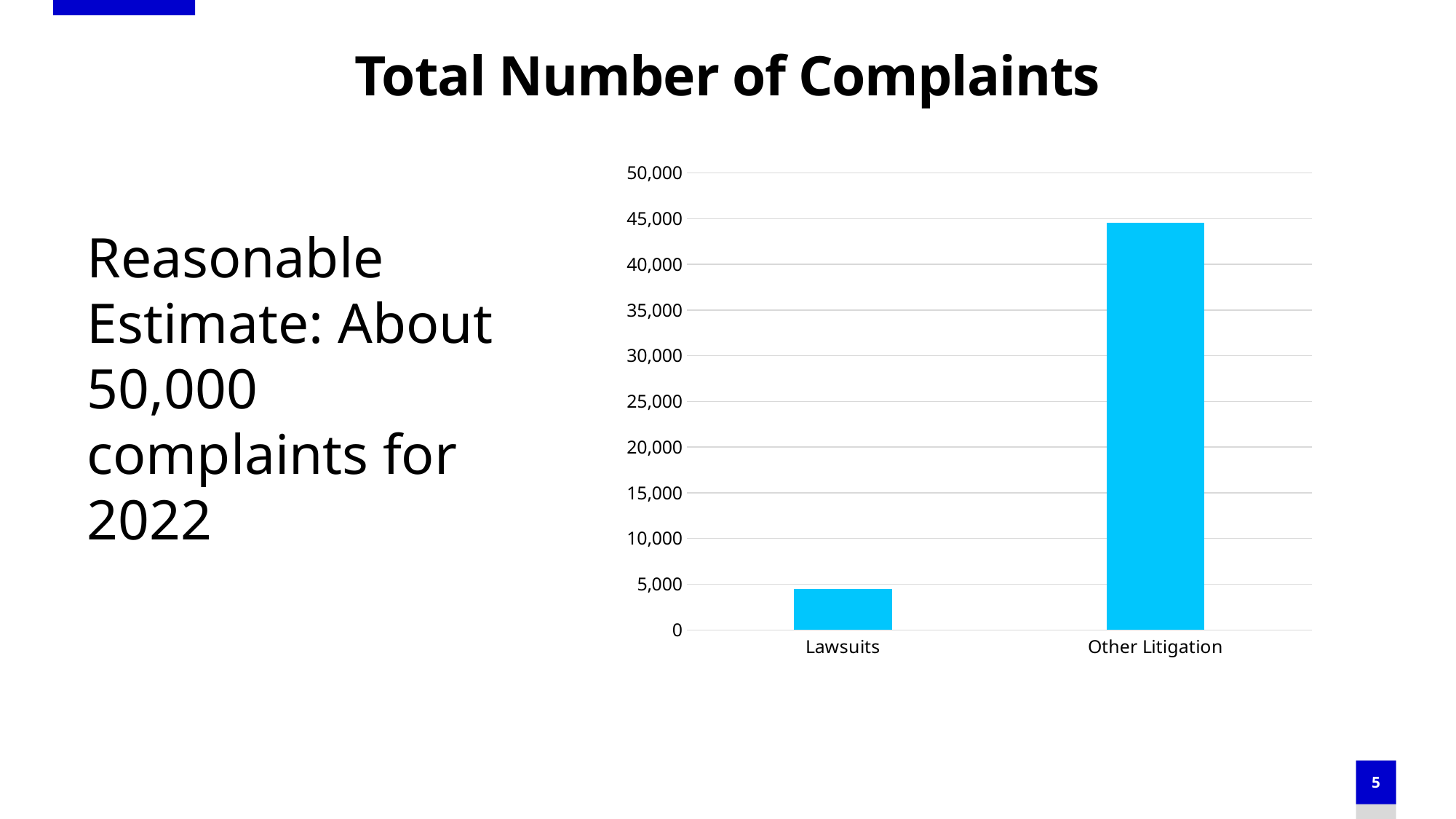
Which category has the highest value in the chart? Other Litigation Which is larger, the value for Lawsuits or the value for Other Litigation? Other Litigation Is the value for Other Litigation greater or less than 40,000? greater Is the value for Other Litigation greater or less than 50,000? less Is the value for Lawsuits greater or less than 10,000? less What is the title of the slide containing the chart? Total Number of Complaints What is the highest value shown on the chart's vertical axis? 50,000 What kind of chart is shown on the slide? bar chart How many categories are plotted in the chart? 2 Which category has the lowest value in the chart? Lawsuits